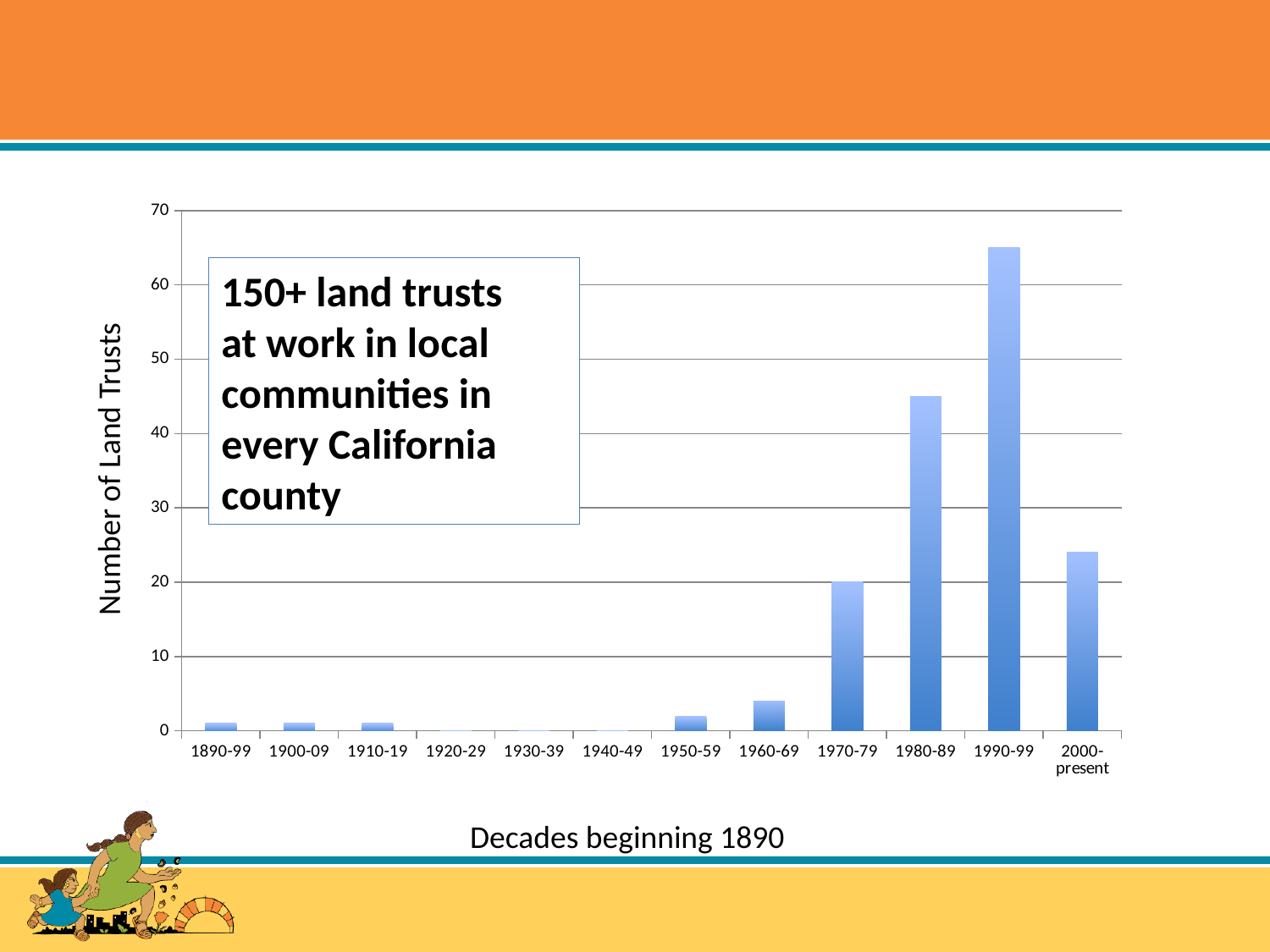
Which decade has the highest number of land trusts? 1990-99 What is the label of the x axis? Decades beginning 1890 Is the value for 1980-89 greater or less than 40? greater What is the number of land trusts for 1970-79? 20 Is the value for 2000-present greater or less than 20? greater Which has more land trusts, 1970-79 or 1960-69? 1970-79 Which has more land trusts, 1980-89 or 2000-present? 1980-89 How many decade categories are shown on the x axis? 12 What is the label of the y axis? Number of Land Trusts Is the value for 1960-69 greater or less than 10? less What kind of chart is shown on the slide? bar chart